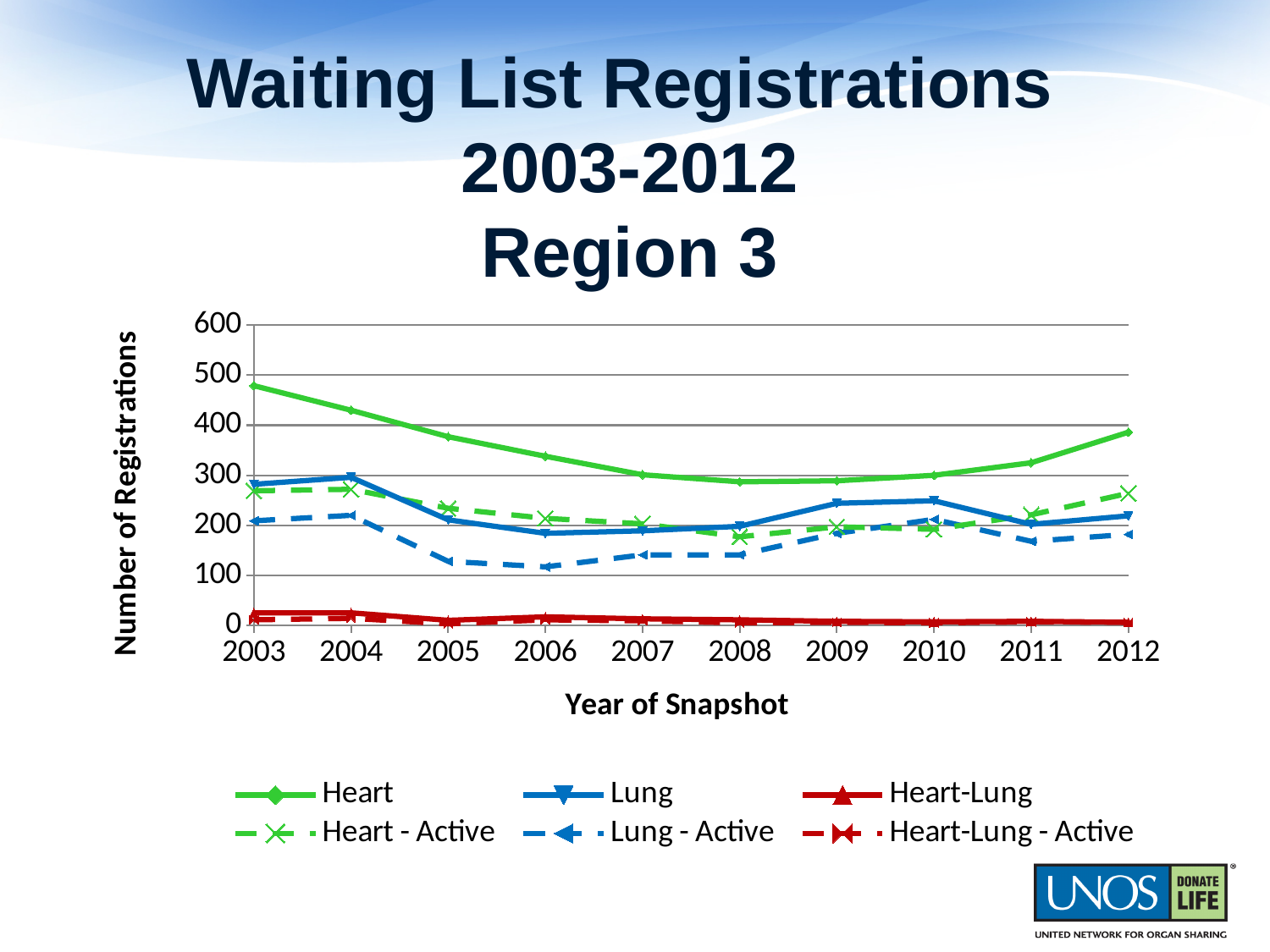
How many series does the legend list? 6 Does the Heart series rise or fall from 2003 to 2008? fall Which series has the highest value in 2012? Heart Is the value for Heart in 2006 greater or less than 300? greater Is the value for Heart-Lung in 2012 greater or less than 100? less Is the value for Lung - Active in 2006 greater or less than 200? less What kind of chart is shown on the slide? line chart In which year is the Heart series at its highest? 2003 How many years are shown along the x axis? 10 Which is larger in 2003, Heart or Lung? Heart